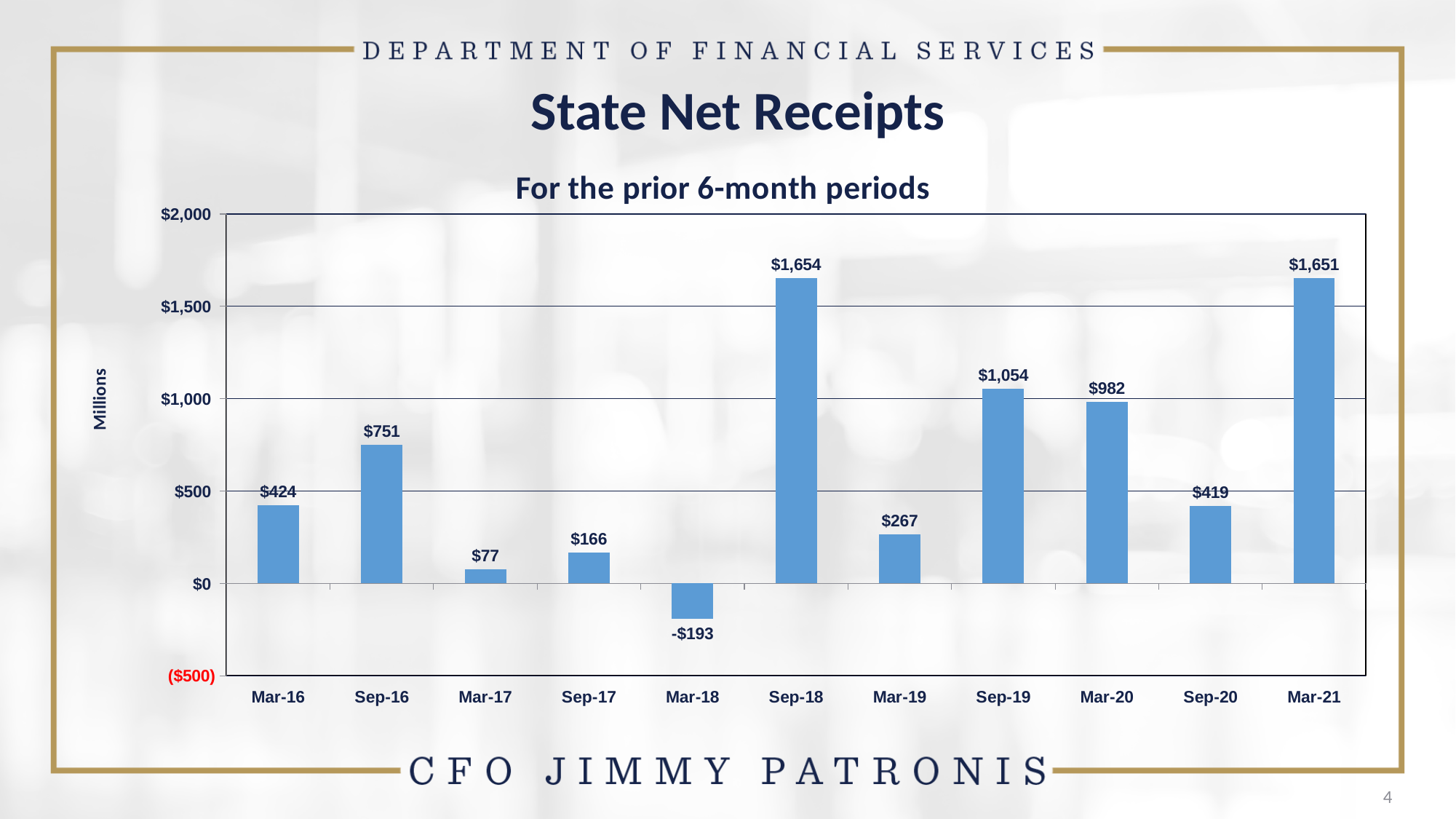
What is the difference between the values for Mar-20 and Sep-20? $563 What is the value for Mar-18? -$193 What is the value for Sep-18? $1,654 Is the value for Mar-19 greater or less than $500? less What is the title of the chart? For the prior 6-month periods What is the value for Sep-20? $419 Which is larger, the value for Sep-19 or the value for Mar-20? Sep-19 What is the difference between the values for Sep-16 and Mar-16? $327 How many periods are shown on the x axis? 11 What kind of chart is shown? bar chart Which period has the highest value? Sep-18 Which period has the lowest value? Mar-18